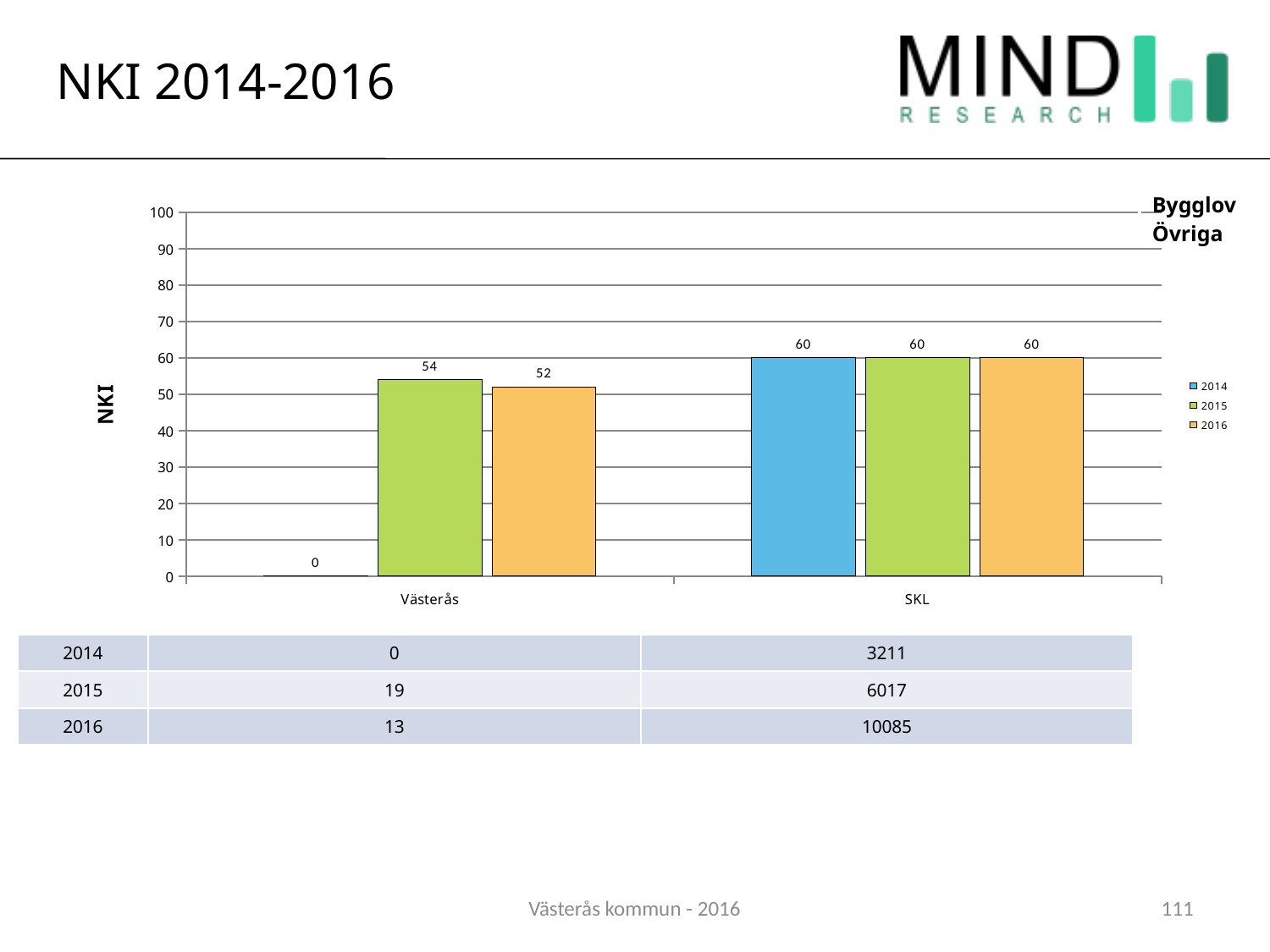
What is the NKI value for Västerås in 2014? 0 What is the NKI value for Västerås in 2016? 52 How many series does the legend list? 3 What is the NKI value for SKL in 2014? 60 How many categories are shown on the x axis? 2 Which year is shown in blue in the legend? 2014 What kind of chart is shown on the slide? Bar chart What is the NKI value for Västerås in 2015? 54 Which is larger, the 2015 NKI value for Västerås or for SKL? SKL What is the label on the y axis of the chart? NKI Did the NKI value for Västerås rise or fall from 2015 to 2016? Fall What is the difference between the SKL and Västerås NKI values for 2016? 8